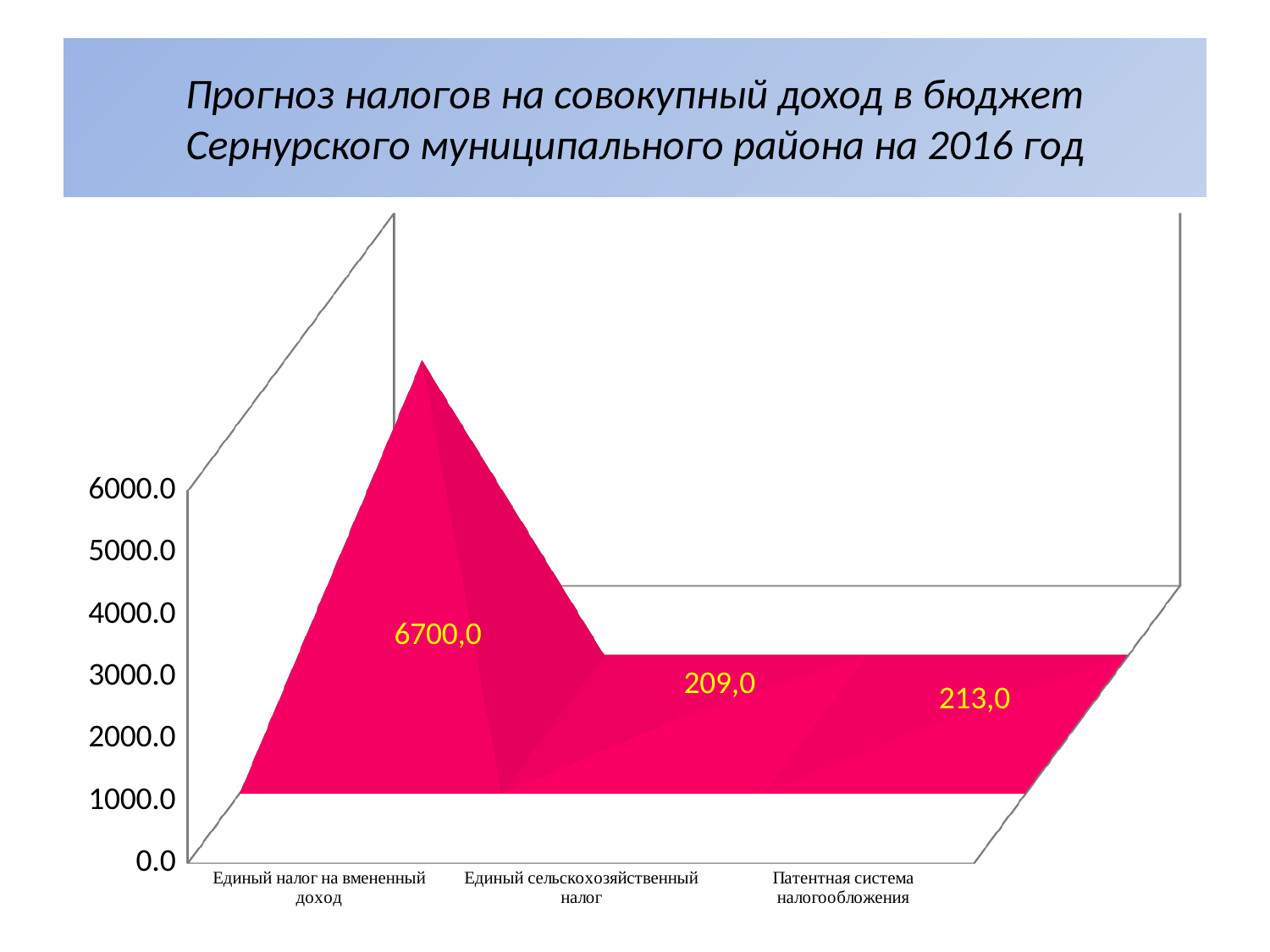
Which is larger: the value for Патентная система налогообложения or the value for Единый сельскохозяйственный налог? Патентная система налогообложения Does the value rise or fall from Единый налог на вмененный доход to Единый сельскохозяйственный налог? fall What is the value for Патентная система налогообложения? 213,0 What is the difference between the value for Патентная система налогообложения and the value for Единый сельскохозяйственный налог? 4,0 What is the value for Единый налог на вмененный доход? 6700,0 What is the title of the slide? Прогноз налогов на совокупный доход в бюджет Сернурского муниципального района на 2016 год Which category has the highest value? Единый налог на вмененный доход What is the value for Единый сельскохозяйственный налог? 209,0 How many categories are shown on the x axis? 3 What is the difference between the value for Единый налог на вмененный доход and the value for Единый сельскохозяйственный налог? 6491,0 What kind of chart is shown on the slide? area chart Which category has the lowest value? Единый сельскохозяйственный налог